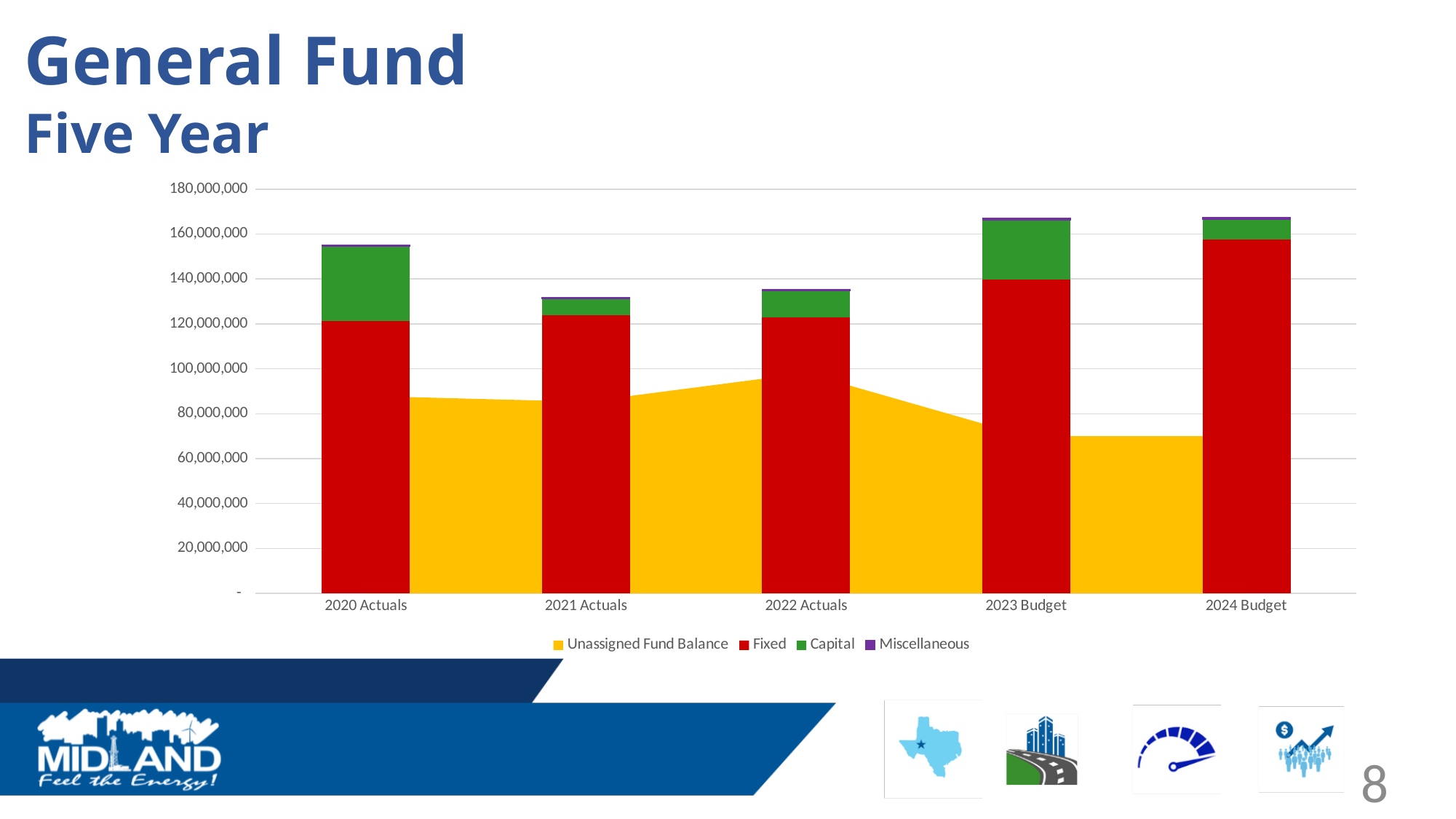
Which is larger, the Fixed value for 2023 Budget or for 2024 Budget? 2024 Budget Does the Unassigned Fund Balance rise or fall from 2022 Actuals to 2024 Budget? Fall Is the total stacked bar for 2023 Budget greater or less than 160,000,000? greater Which category has the highest Fixed value? 2024 Budget How many series does the chart's legend list? 4 Which category has the highest Capital value? 2020 Actuals What kind of chart is shown on the slide? Combination bar and area chart Is the Fixed value for 2020 Actuals greater or less than 140,000,000? less Is the Unassigned Fund Balance for 2024 Budget greater or less than 80,000,000? less Which series is shown in red in the chart's legend? Fixed How many categories are shown on the x axis of the chart? 5